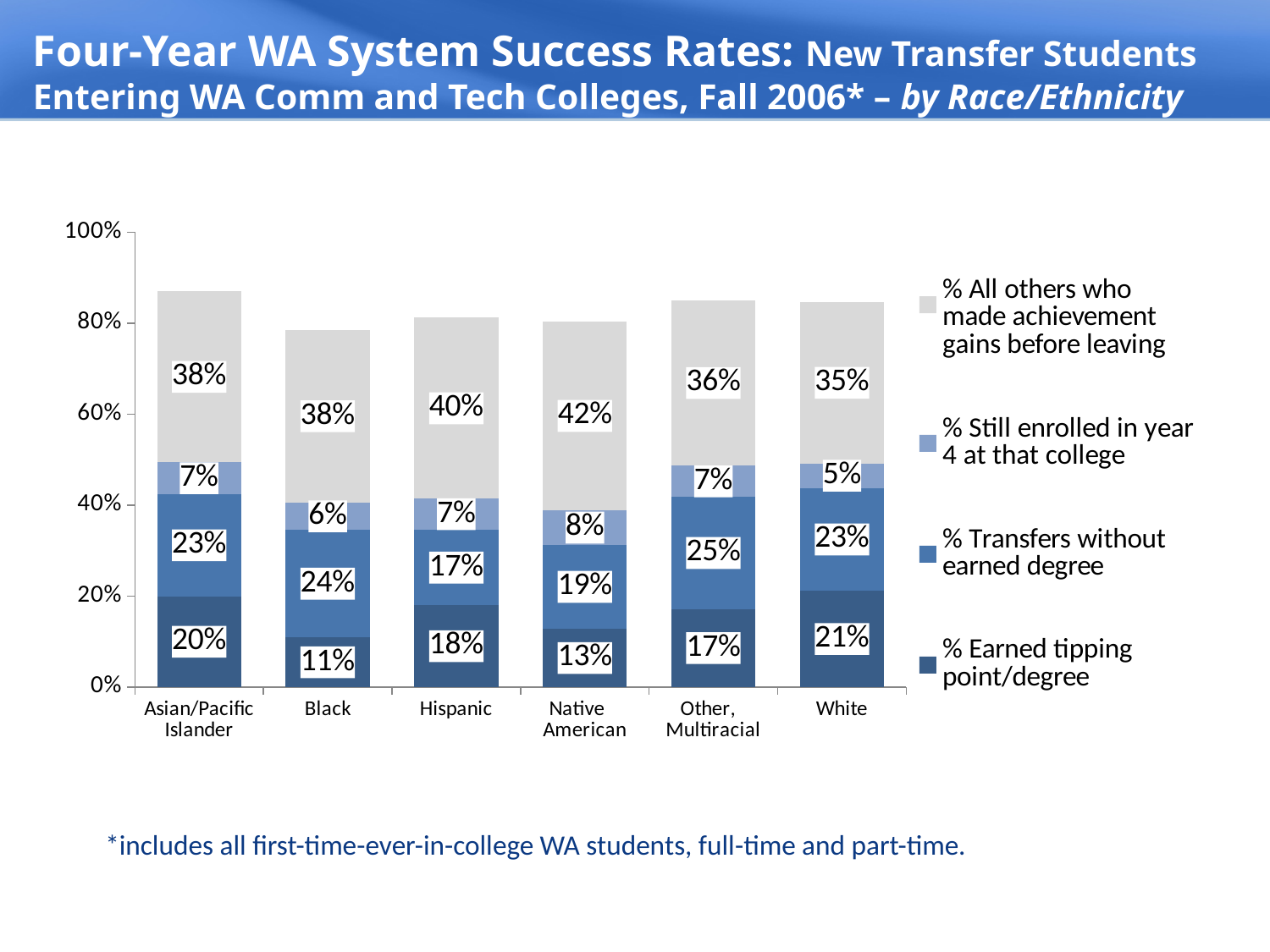
Which race/ethnicity group has the highest % Earned tipping point/degree? White What is the difference between the % Transfers without earned degree for Other, Multiracial and for Hispanic students? 8 percentage points What is the % Earned tipping point/degree value for Black students? 11% Which is larger: the % Earned tipping point/degree for Asian/Pacific Islander or for Native American students? Asian/Pacific Islander What kind of chart is shown on the slide? Stacked bar chart What is the % Still enrolled in year 4 at that college value for Native American students? 8% What is the total of the four stacked segments for Black students? 79% Which race/ethnicity group has the lowest % Still enrolled in year 4 at that college? White What is the % Transfers without earned degree value for Other, Multiracial students? 25% How many race/ethnicity categories are shown on the x axis? 6 Which race/ethnicity group has the highest % All others who made achievement gains before leaving? Native American How many series does the legend list? 4